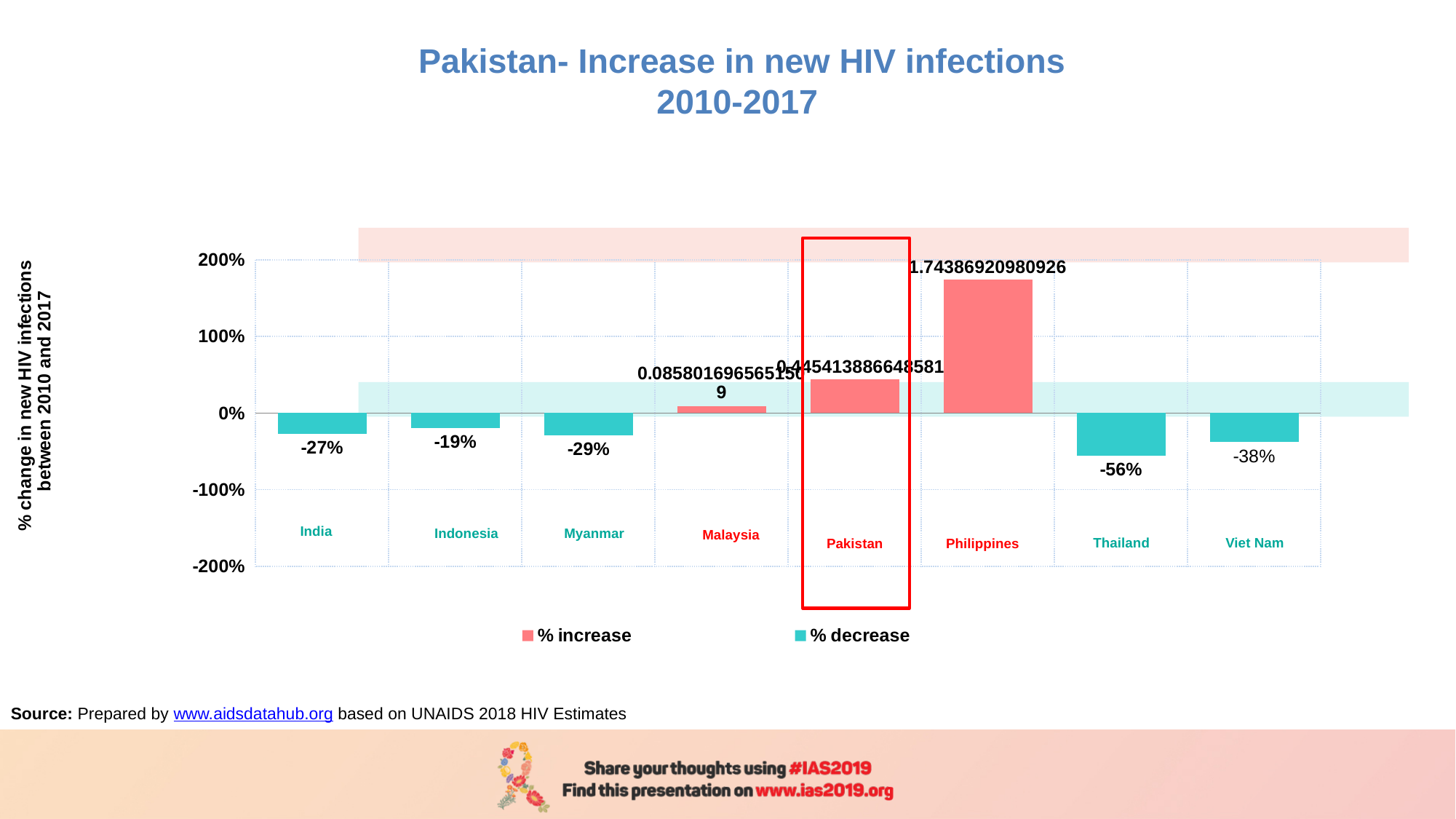
Which country has the lowest value in the chart? Thailand Which country has the highest value in the chart? Philippines What is the value shown for India? -27% Is the value for Pakistan greater or less than 100%? less What type of chart is shown on the slide? bar chart What is the value shown for Thailand? -56% What is the value shown for Viet Nam? -38% What is the data label shown for Philippines? 1.74386920980926 What is the difference between the values for Thailand and India? 29% How many series does the legend list? 2 Which has a larger value, Indonesia or Myanmar? Indonesia How many countries are shown in the chart? 8